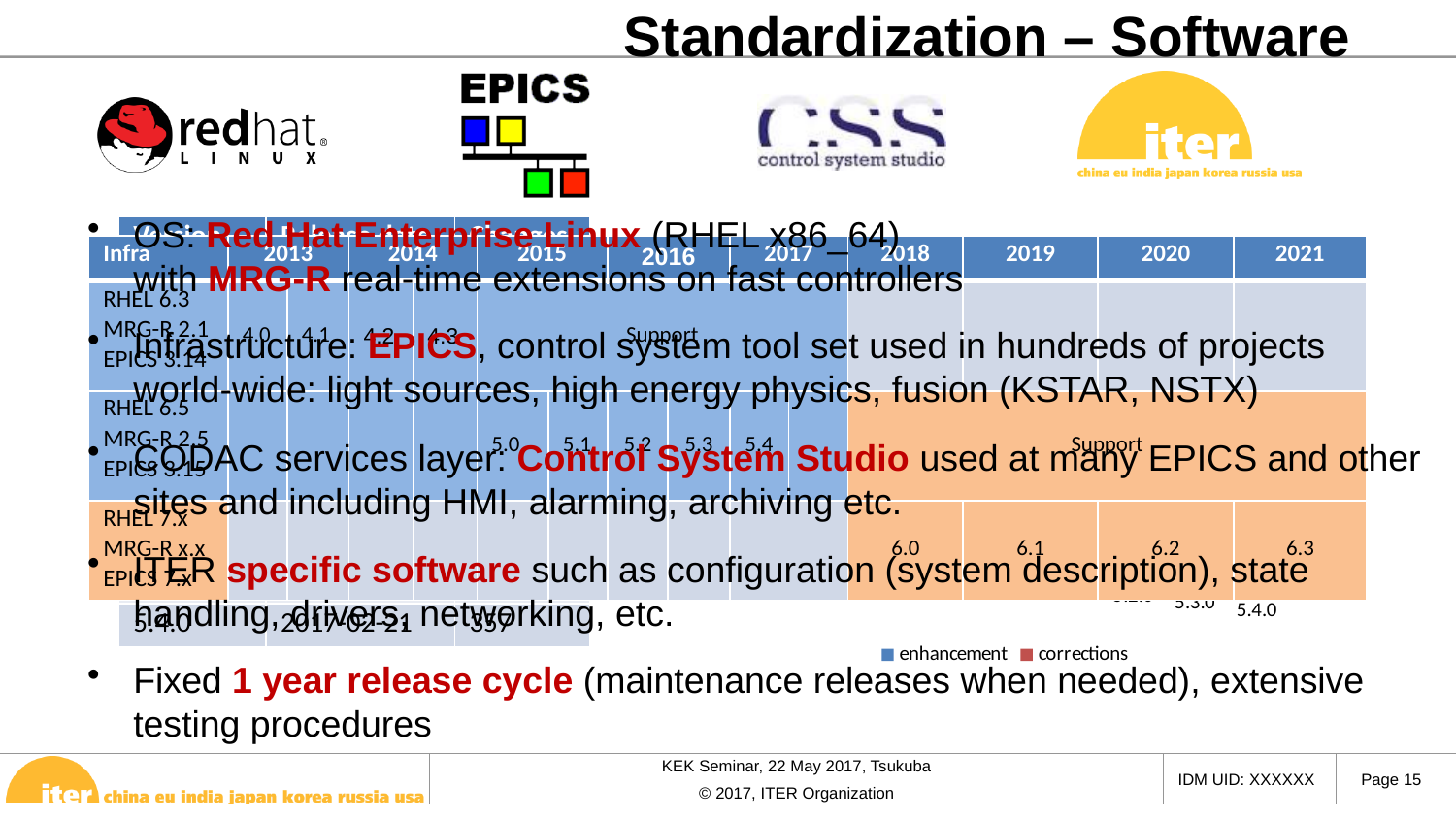
What are the two legend entries shown below the timeline chart? enhancement, corrections Which legend entry in the timeline chart is shown in blue? enhancement How many year columns does the timeline chart header show? 9 What is the first year shown in the timeline chart header? 2013 How many entries does the legend below the timeline chart list? 2 What is the last year shown in the timeline chart header? 2021